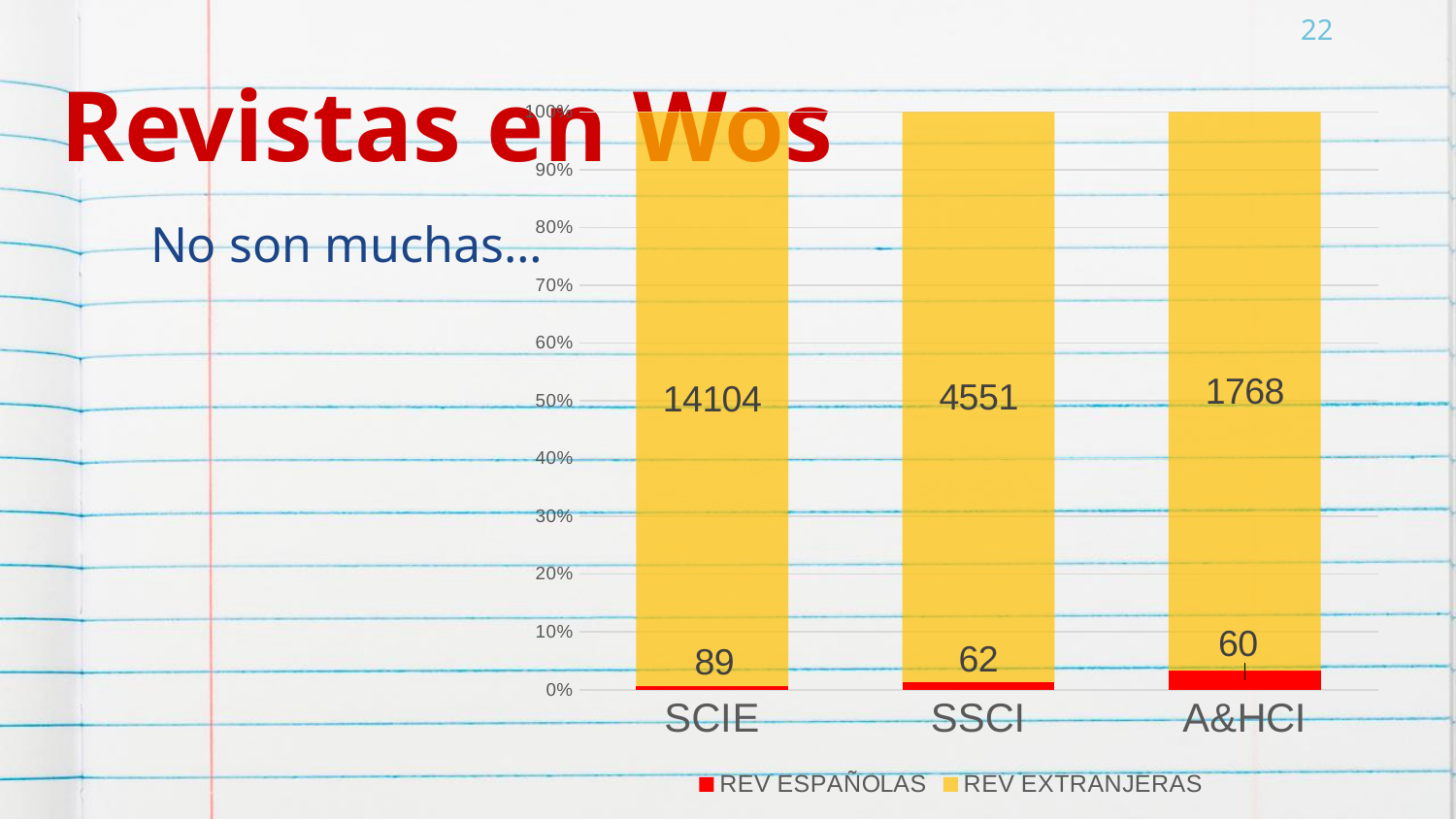
What is the value for REV EXTRANJERAS in the SCIE category? 14104 What is the difference between the REV EXTRANJERAS values for SSCI and A&HCI? 2783 What is the value for REV ESPAÑOLAS in the A&HCI category? 60 Which category has the lowest value for REV ESPAÑOLAS? A&HCI How many categories are shown on the x axis? 3 What kind of chart is shown on the slide? Stacked bar chart What is the value for REV EXTRANJERAS in the A&HCI category? 1768 Which category has the highest value for REV EXTRANJERAS? SCIE Which is larger, the REV ESPAÑOLAS value for SCIE or for SSCI? SCIE What is the combined total of REV ESPAÑOLAS and REV EXTRANJERAS for SSCI? 4613 What is the value for REV ESPAÑOLAS in the SSCI category? 62 How many series does the legend list? 2